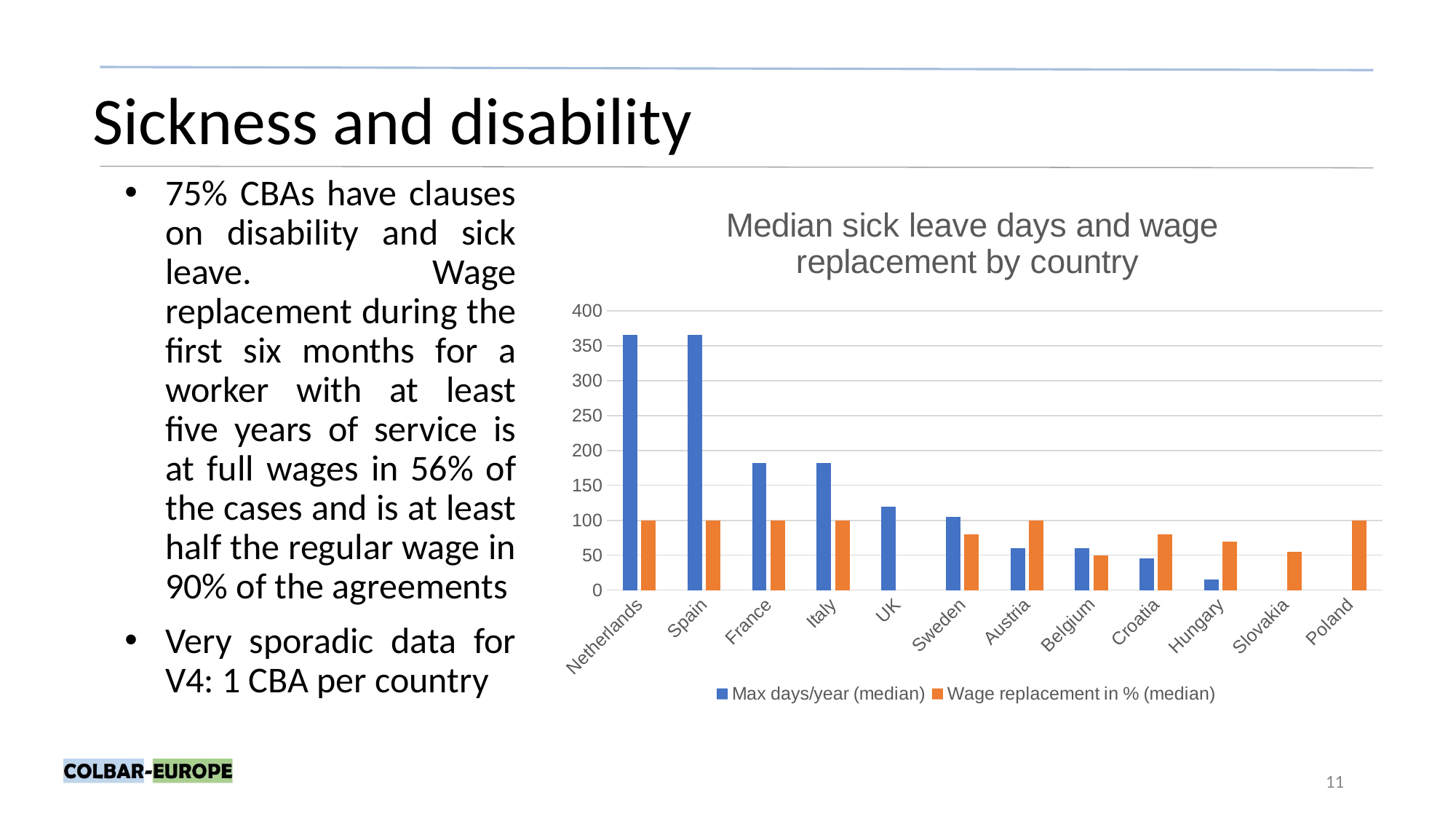
Which is larger, the Wage replacement in % (median) for Austria or for Belgium? Austria How many countries are shown on the x axis of the chart? 12 Is the Wage replacement in % (median) value for Belgium greater or less than 100? less How many series does the chart legend list? 2 What type of chart is shown on the slide? bar chart Which series is shown in orange in the chart? Wage replacement in % (median) Is the Max days/year (median) value for France greater or less than 150? greater Which is larger, the Max days/year (median) for UK or for Croatia? UK Is the Max days/year (median) value for Netherlands greater or less than 350? greater What is the title of the chart? Median sick leave days and wage replacement by country Which country has the lowest Max days/year (median) among the countries with a blue bar? Hungary